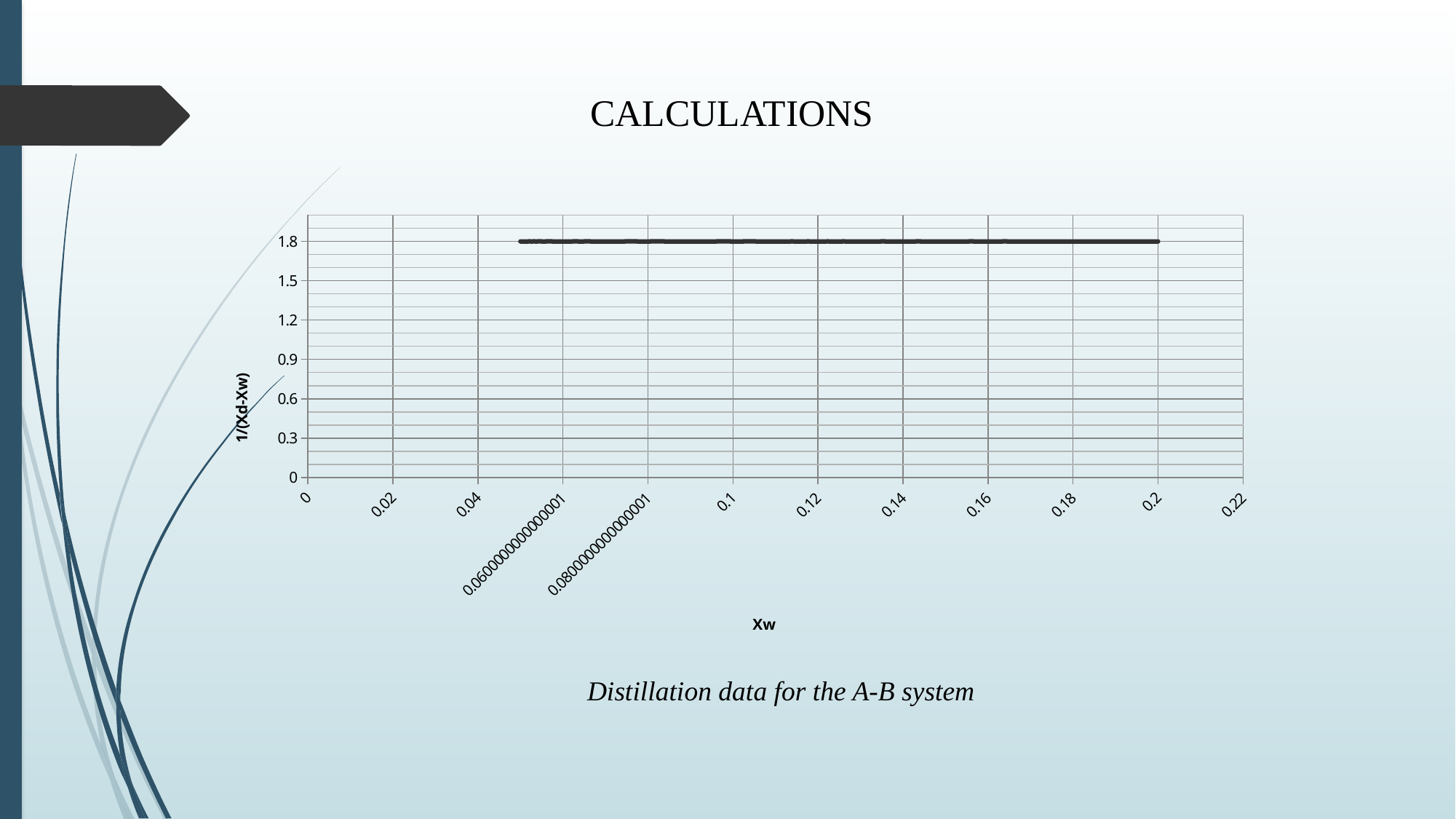
What kind of chart is shown on the slide? line chart Is the value of 1/(Xd-Xw) at Xw = 0.2 greater or less than 0.9? greater Is the value of 1/(Xd-Xw) at Xw = 0.16 greater or less than 1.2? greater Is the value of 1/(Xd-Xw) at Xw = 0.12 larger than, smaller than, or the same as the value at Xw = 0.18? the same Is the value of 1/(Xd-Xw) at Xw = 0.1 greater or less than 1.5? greater What is the label of the horizontal axis of the chart? Xw What value of 1/(Xd-Xw) does the plotted line sit on across the chart? 1.8 What is the label of the vertical axis of the chart? 1/(Xd-Xw) Do the plotted values of 1/(Xd-Xw) rise, fall, or stay constant as Xw increases? stay constant What is the highest tick value labelled on the vertical axis? 1.8